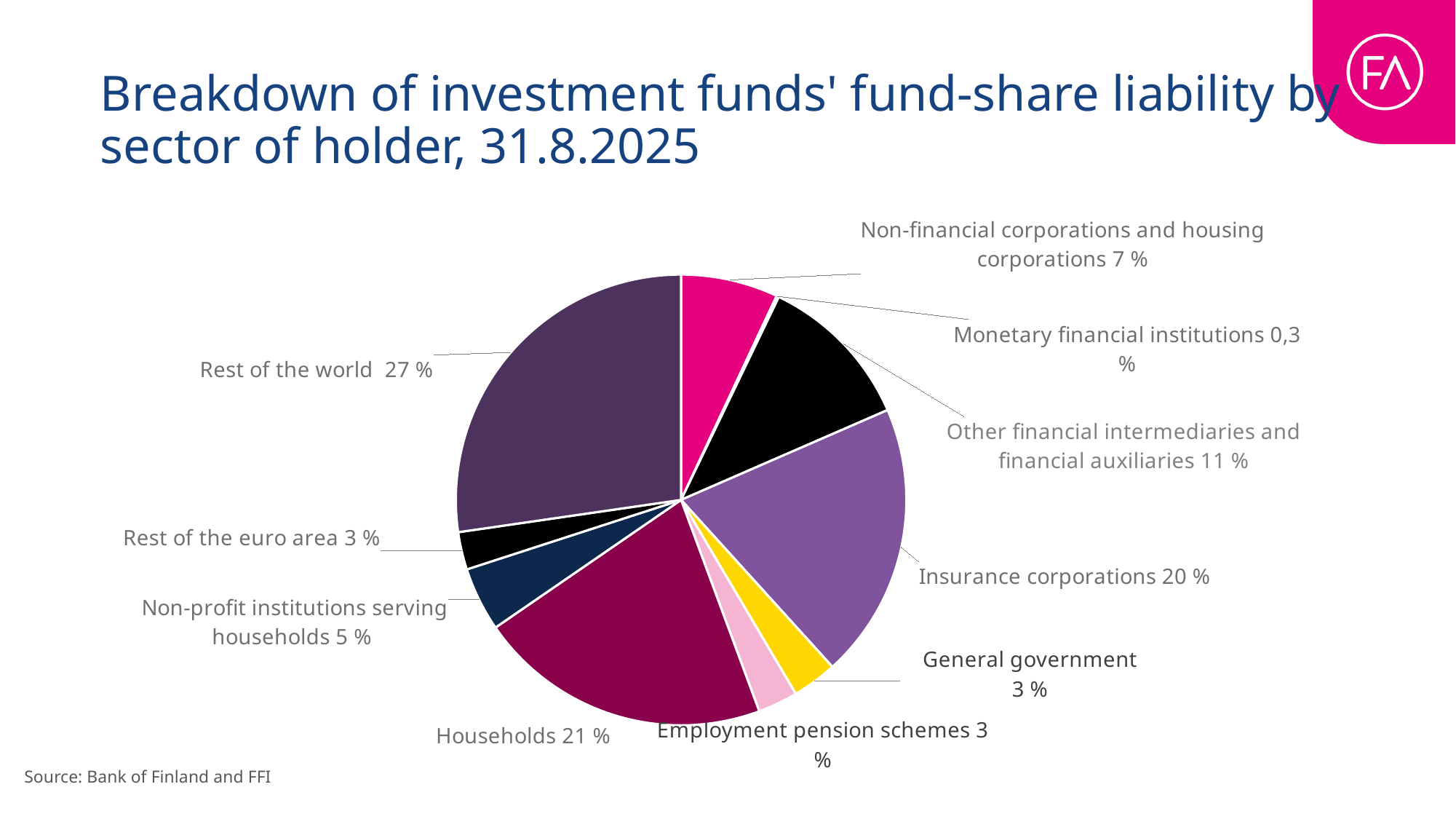
What share is held by Monetary financial institutions? 0,3 % What share is held by Households? 21 % Which is larger: the share of Other financial intermediaries and financial auxiliaries or the share of Non-financial corporations and housing corporations? Other financial intermediaries and financial auxiliaries What is the difference in percentage points between the Rest of the world share and the Households share? 6 % Which sector of holder has the smallest share of the pie? Monetary financial institutions What share is held by Insurance corporations? 20 % What is the title of the chart on the slide? Breakdown of investment funds' fund-share liability by sector of holder, 31.8.2025 What share is held by Non-profit institutions serving households? 5 % What kind of chart is shown on the slide? Pie chart What share of investment funds' fund-share liability is held by Rest of the world? 27 % How many sectors of holder are shown in the pie chart? 10 Which sector of holder has the largest share of the pie? Rest of the world